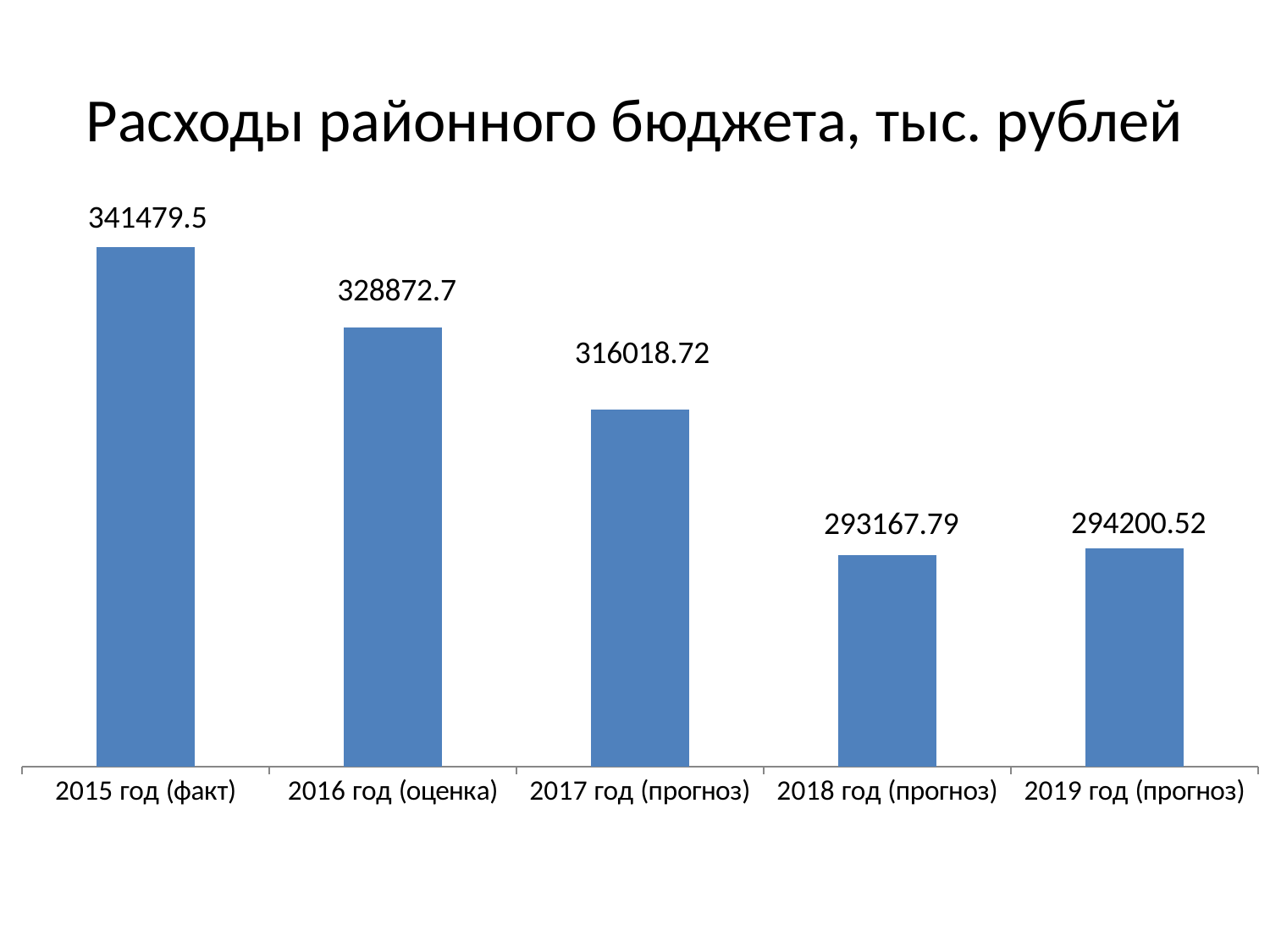
What is the difference between the values for 2019 год (прогноз) and 2018 год (прогноз)? 1032.73 What kind of chart is shown on the slide? Bar chart What is the value for 2017 год (прогноз)? 316018.72 What is the value for 2015 год (факт)? 341479.5 How many categories are shown on the chart? 5 Which is larger, the value for 2018 год (прогноз) or 2019 год (прогноз)? 2019 год (прогноз) What is the difference between the values for 2015 год (факт) and 2016 год (оценка)? 12606.8 What is the value for 2019 год (прогноз)? 294200.52 Which category has the highest value? 2015 год (факт) Do the values rise or fall from 2015 год (факт) to 2018 год (прогноз)? Fall Which category has the lowest value? 2018 год (прогноз) What is the title of the chart? Расходы районного бюджета, тыс. рублей